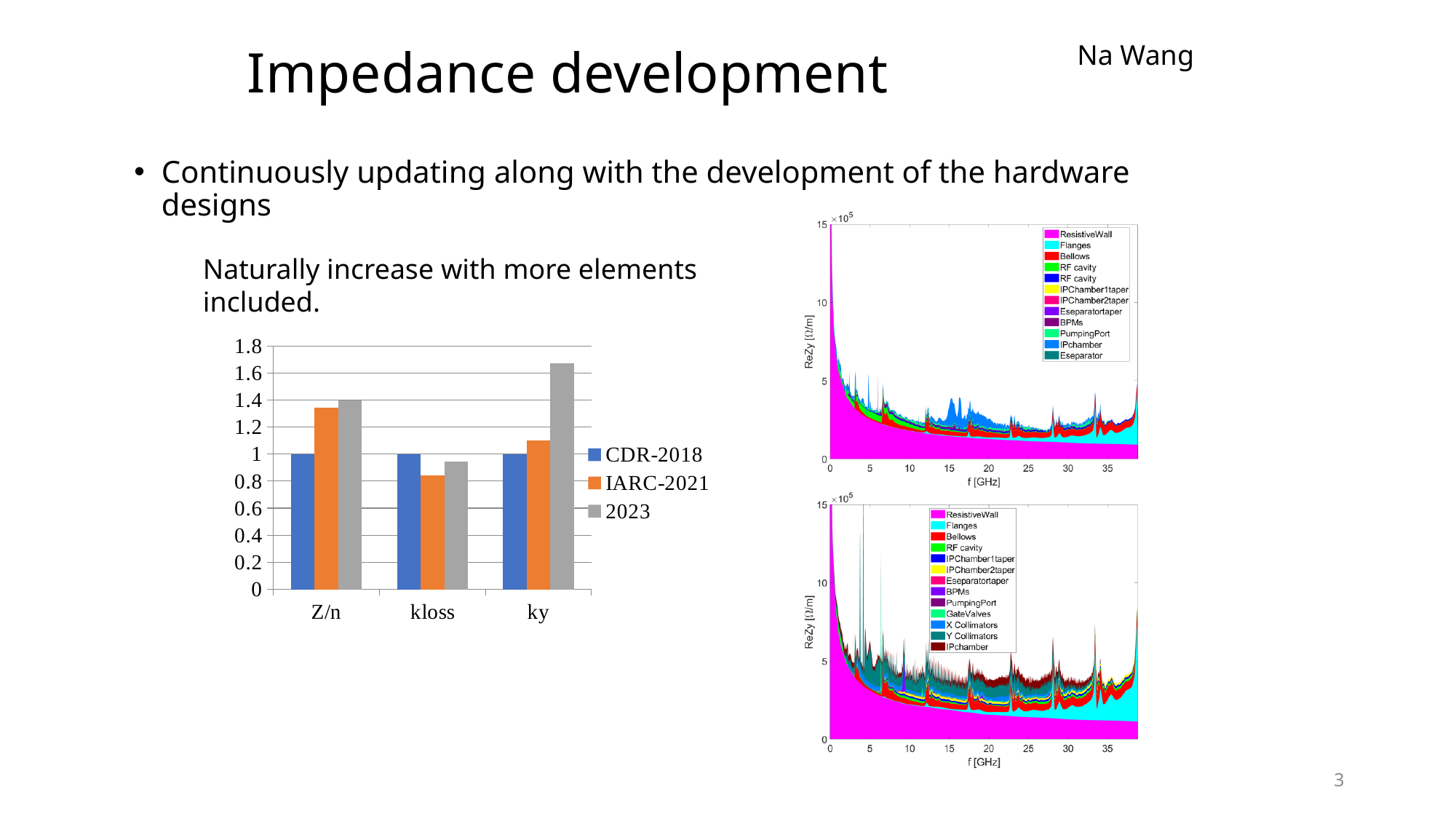
In the bar chart on the left, what is the CDR-2018 value for ky? 1 In the bar chart on the left, is the 2023 value for ky greater or less than 1.6? greater What kind of chart is the chart on the left of the slide with categories Z/n, kloss and ky? bar chart In the bar chart on the left, how many categories are shown on the x axis? 3 In the bar chart on the left, which category has the highest 2023 value? ky In the bottom-right chart, how many entries does the legend list? 13 In the bar chart on the left, what is the CDR-2018 value for Z/n? 1 In the bar chart on the left, which category has the lowest IARC-2021 value? kloss In the bar chart on the left, how many series does the legend list? 3 In the bar chart on the left, is the IARC-2021 value for kloss greater or less than 1? less In the bar chart on the left, is the IARC-2021 value for Z/n greater or less than 1.2? greater In the bar chart on the left, for kloss, which is larger: the IARC-2021 value or the 2023 value? 2023